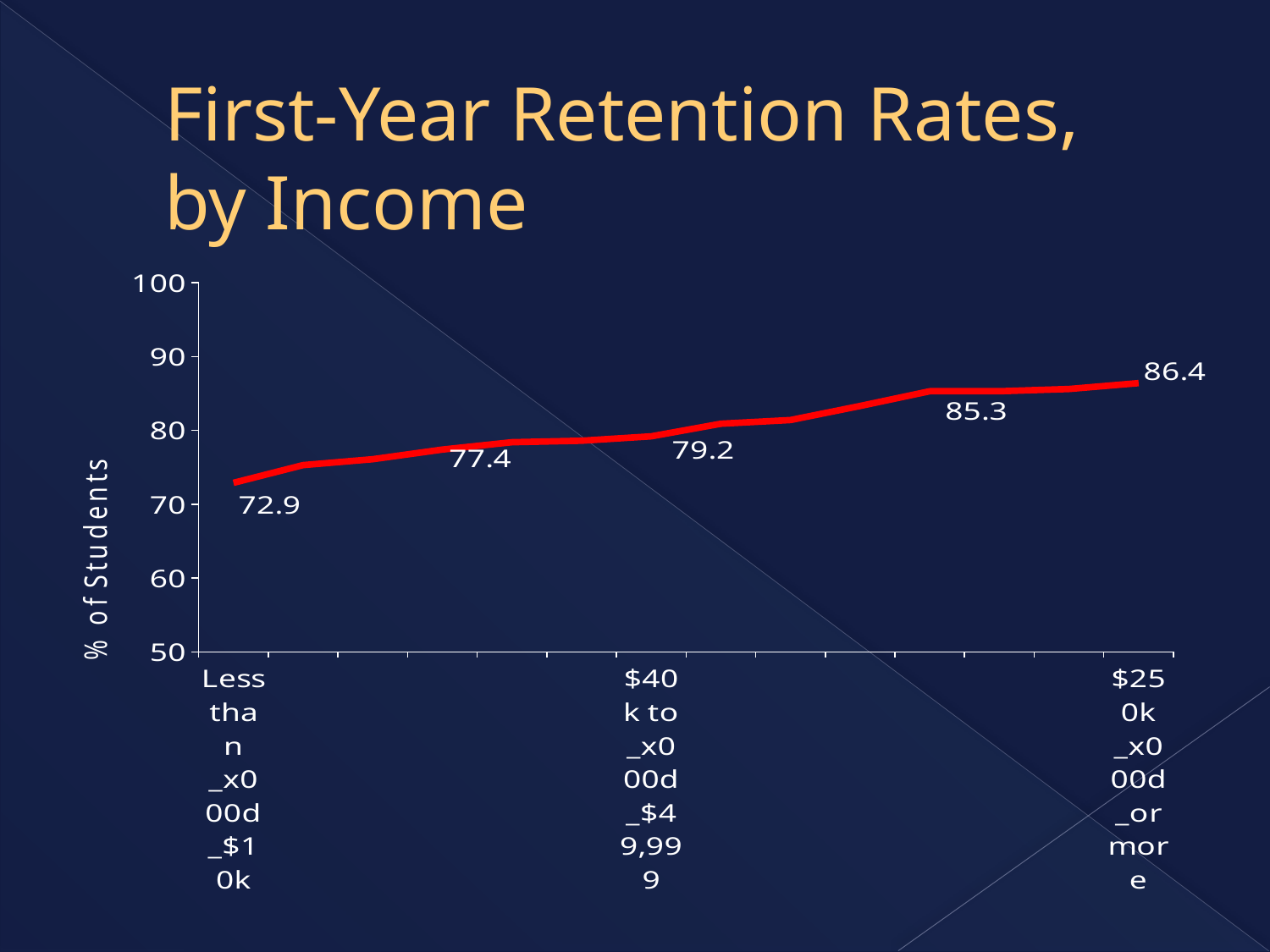
What is the first-year retention rate for the "Less than $10k" income group? 72.9 Which income group has the lowest first-year retention rate? Less than $10k What kind of chart is shown on the slide? line chart How many data points are plotted on the line? 14 What is the first-year retention rate for the "$250k or more" income group? 86.4 Do the retention rates rise or fall as income increases along the x axis? rise What is the first-year retention rate for the "$40k to $49,999" income group? 79.2 What is the difference between the retention rate for "$250k or more" and "Less than $10k"? 13.5 Which income group has the highest first-year retention rate? $250k or more What is the title of the chart on the slide? First-Year Retention Rates, by Income